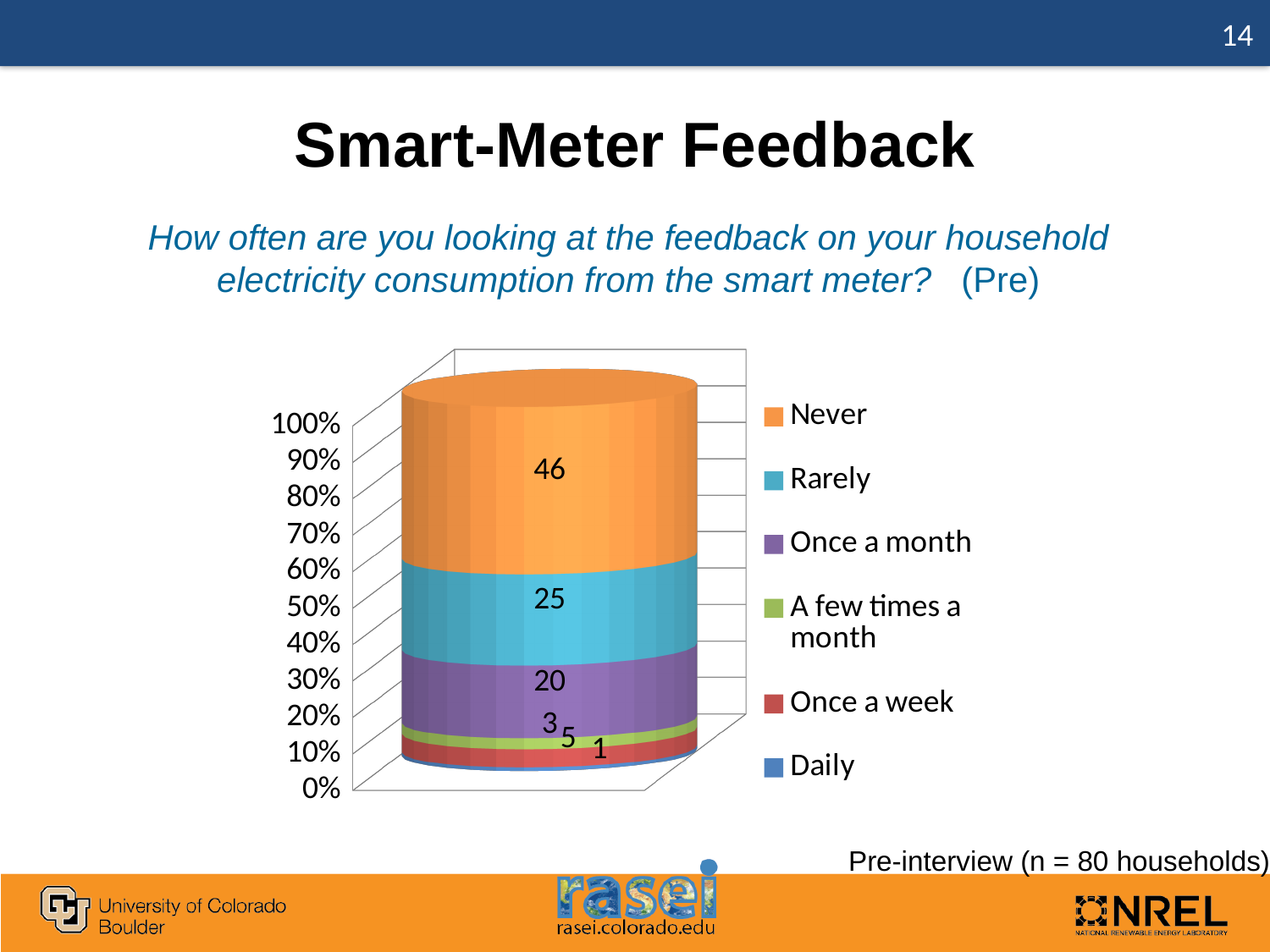
What kind of chart is shown on the slide? Stacked bar chart What value is shown for the Never segment? 46 What is the difference between the Never value and the Rarely value? 21 Which is larger, the Rarely value or the Once a month value? Rarely What value is shown for the Daily segment? 1 Which response category has the smallest segment in the stacked bar? Daily What is the total of all segments in the stacked bar? 100 What value is shown for the Once a month segment? 20 What value is shown for the Rarely segment? 25 What value is shown for the Once a week segment? 5 Which response category has the largest segment in the stacked bar? Never How many series does the legend list? 6